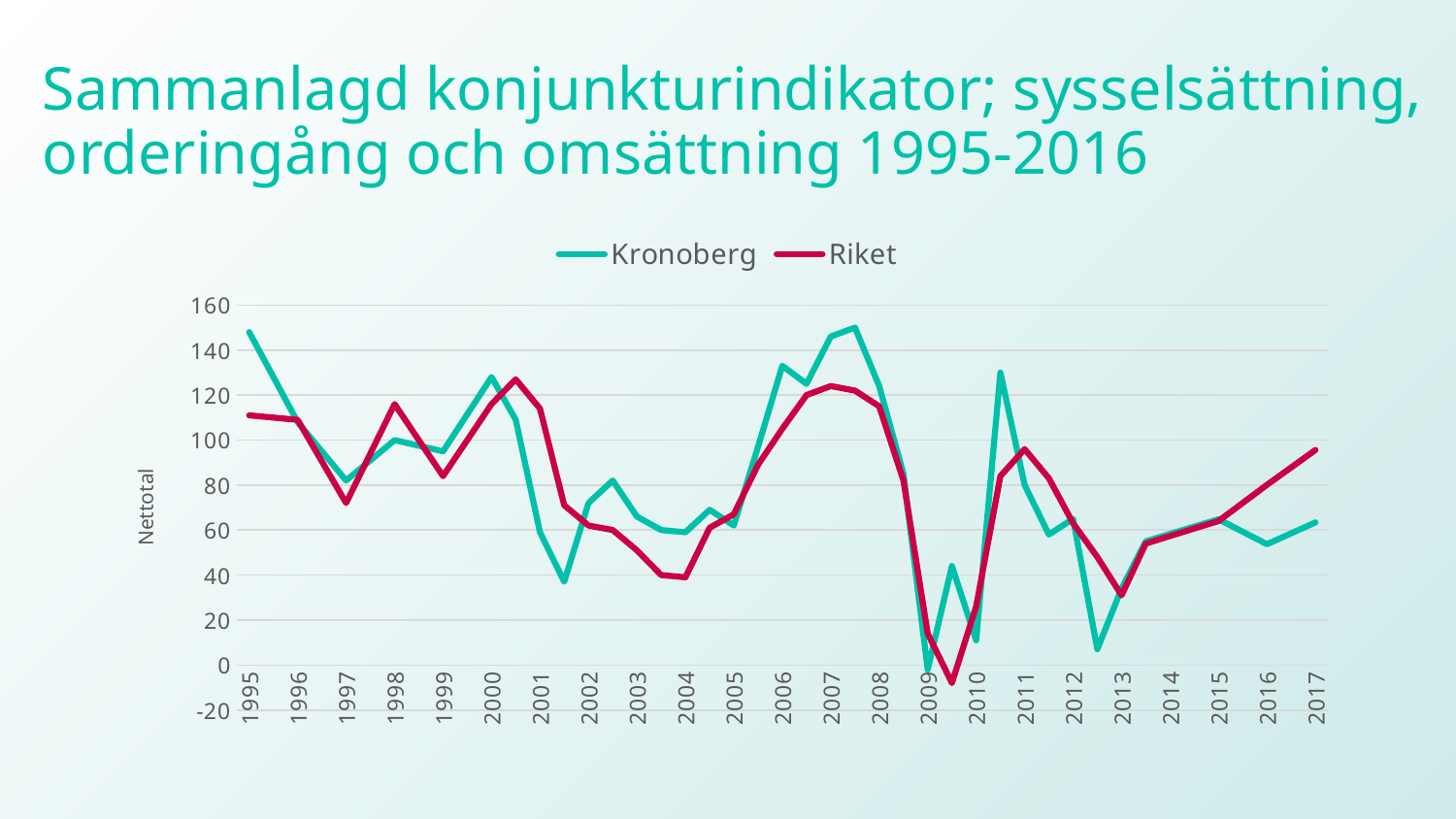
What kind of chart is shown on the slide? line chart In which year does the Riket series reach its lowest value? 2009 Is the value for Kronoberg in 2009 greater or less than 20? less Is the value for Riket in 1995 greater or less than 100? greater What is the label on the vertical axis? Nettotal How many years are labelled along the x axis? 23 Does the Riket series rise or fall from 2013 to 2017? rise Which two series are listed in the legend? Kronoberg and Riket How many series does the legend list? 2 Is the value for Kronoberg in 1995 greater or less than 140? greater